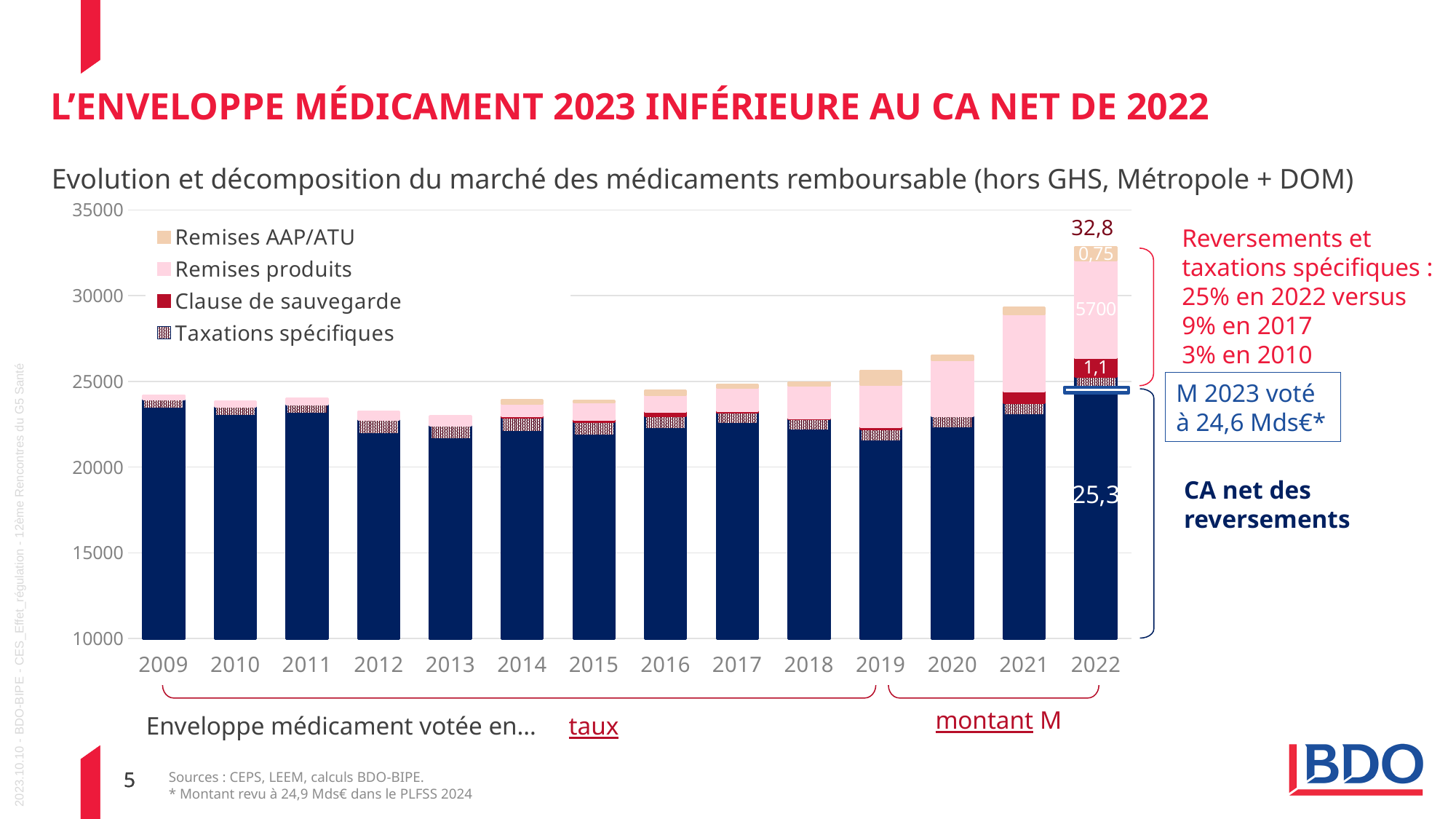
What value is labelled in the dark blue (CA net des reversements) segment of the 2022 bar? 25,3 What value is labelled for Remises produits in the 2022 bar? 5700 What kind of chart is shown on the slide? bar chart What value is labelled for Clause de sauvegarde in the 2022 bar? 1,1 Which year has the taller stacked bar, 2020 or 2021? 2021 Is the total height of the 2021 bar greater or less than 30000? less What total value is labelled above the 2022 bar? 32,8 How many years are shown on the x axis of the chart? 14 Which year has the tallest stacked bar? 2022 What value is labelled for Remises AAP/ATU in the 2022 bar? 0,75 Do the total bar heights rise or fall from 2019 to 2022? rise How many series does the chart legend list? 4